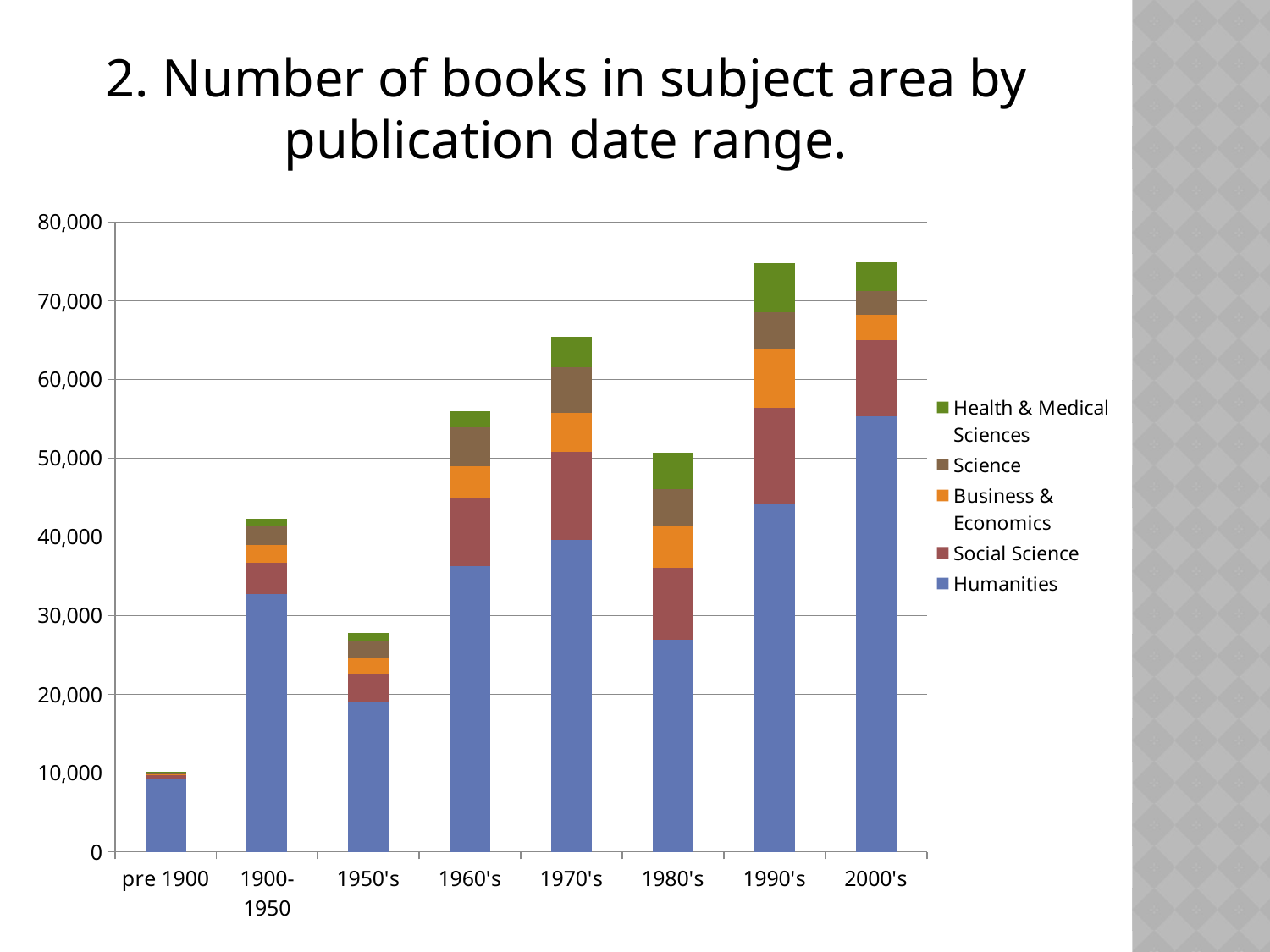
Which publication date range has the largest Humanities segment? 2000's Which publication date range has the lowest total number of books? pre 1900 Does the total number of books rise or fall from the 1950's to the 1970's? rise Which subject area is shown in blue at the bottom of each stacked bar? Humanities What kind of chart is shown on the slide? Stacked bar chart How many publication date ranges are shown on the x axis? 8 How many subject areas does the legend list? 5 Is the Humanities value for the 2000's greater or less than 50,000? greater Which has a larger total number of books, the 1970's or the 1980's? 1970's Is the total number of books for the 1970's greater or less than 60,000? greater Is the total number of books for the 1950's greater or less than 30,000? less